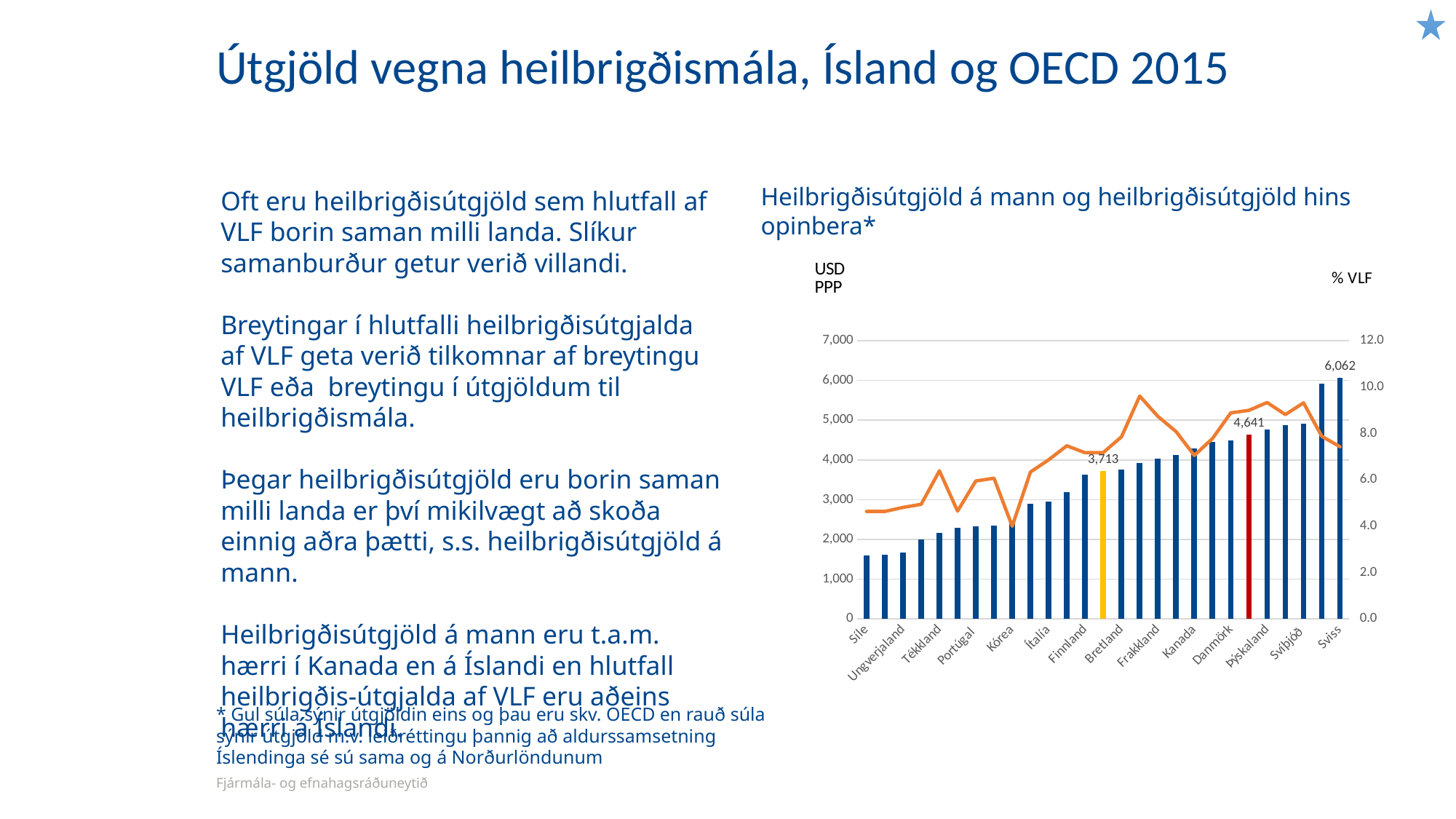
What value is labelled on the red bar? 4,641 What is the difference between the tallest bar (6,062) and the yellow bar (3,713)? 2,349 What is the value labelled on the tallest bar in the chart? 6,062 Do the bar values generally rise or fall from left to right along the x axis? rise What unit is shown on the left vertical axis of the chart? USD PPP How many country names are labelled on the x axis? 14 What kind of chart is shown on the slide? bar chart with a line overlay Which is larger, the yellow bar or the red bar? the red bar What is the difference between the tallest bar (6,062) and the red bar (4,641)? 1,421 What value is labelled on the yellow bar? 3,713 Is the value for Síle greater or less than 2,000? less What is the difference between the red bar (4,641) and the yellow bar (3,713)? 928